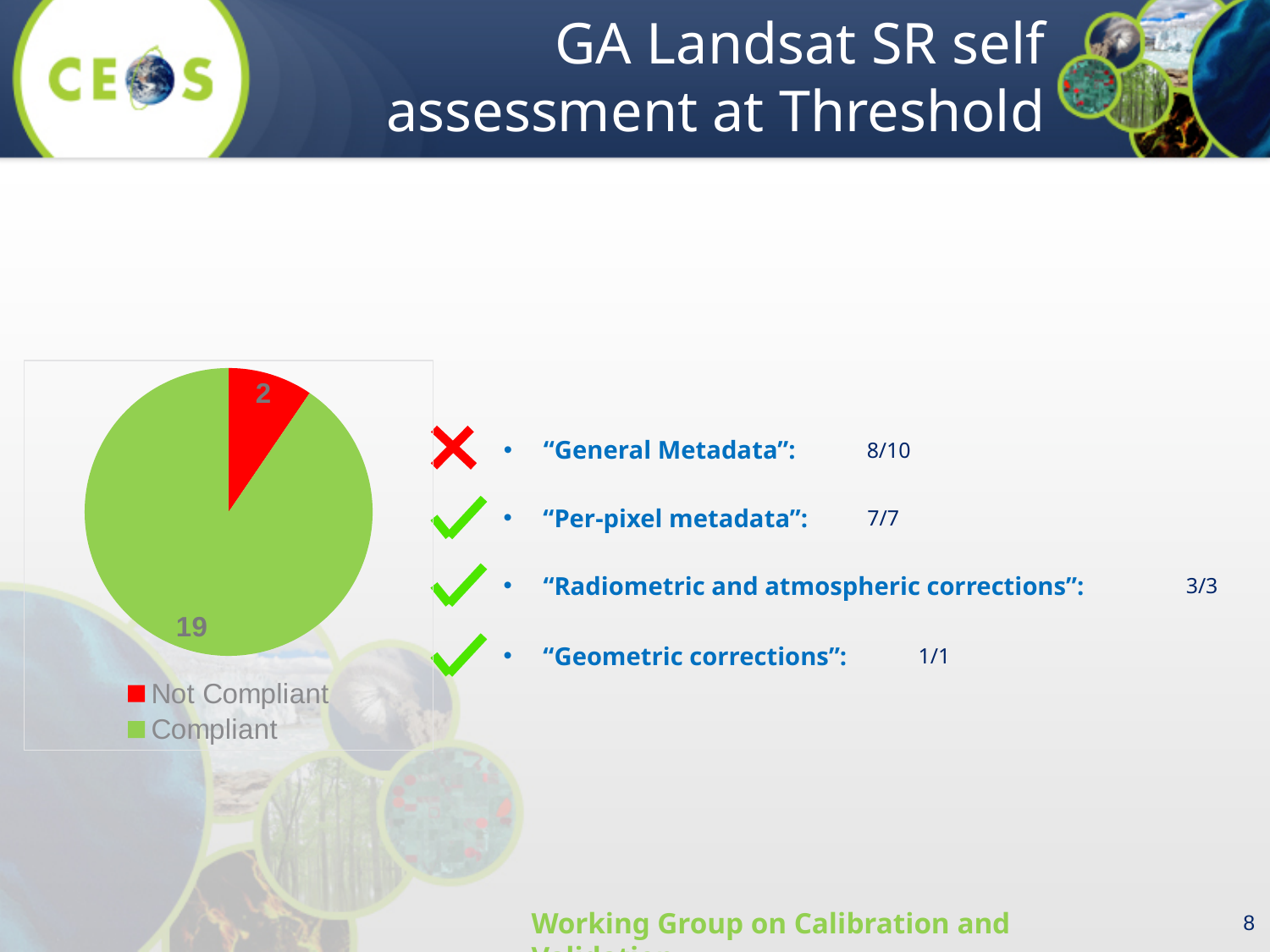
What is the value of the Not Compliant slice in the pie chart? 2 What colour is the Not Compliant slice in the pie chart? red How many entries does the pie chart legend list? 2 Which is larger in the pie chart, Compliant or Not Compliant? Compliant What type of chart is shown on the slide? pie chart Which slice of the pie chart is the largest? Compliant What fraction of the pie chart total does the Compliant slice represent? 19/21 What is the difference between the Compliant and Not Compliant values in the pie chart? 17 What is the total of all slices in the pie chart? 21 How many slices does the pie chart have? 2 What is the value of the Compliant slice in the pie chart? 19 Which slice of the pie chart is the smallest? Not Compliant